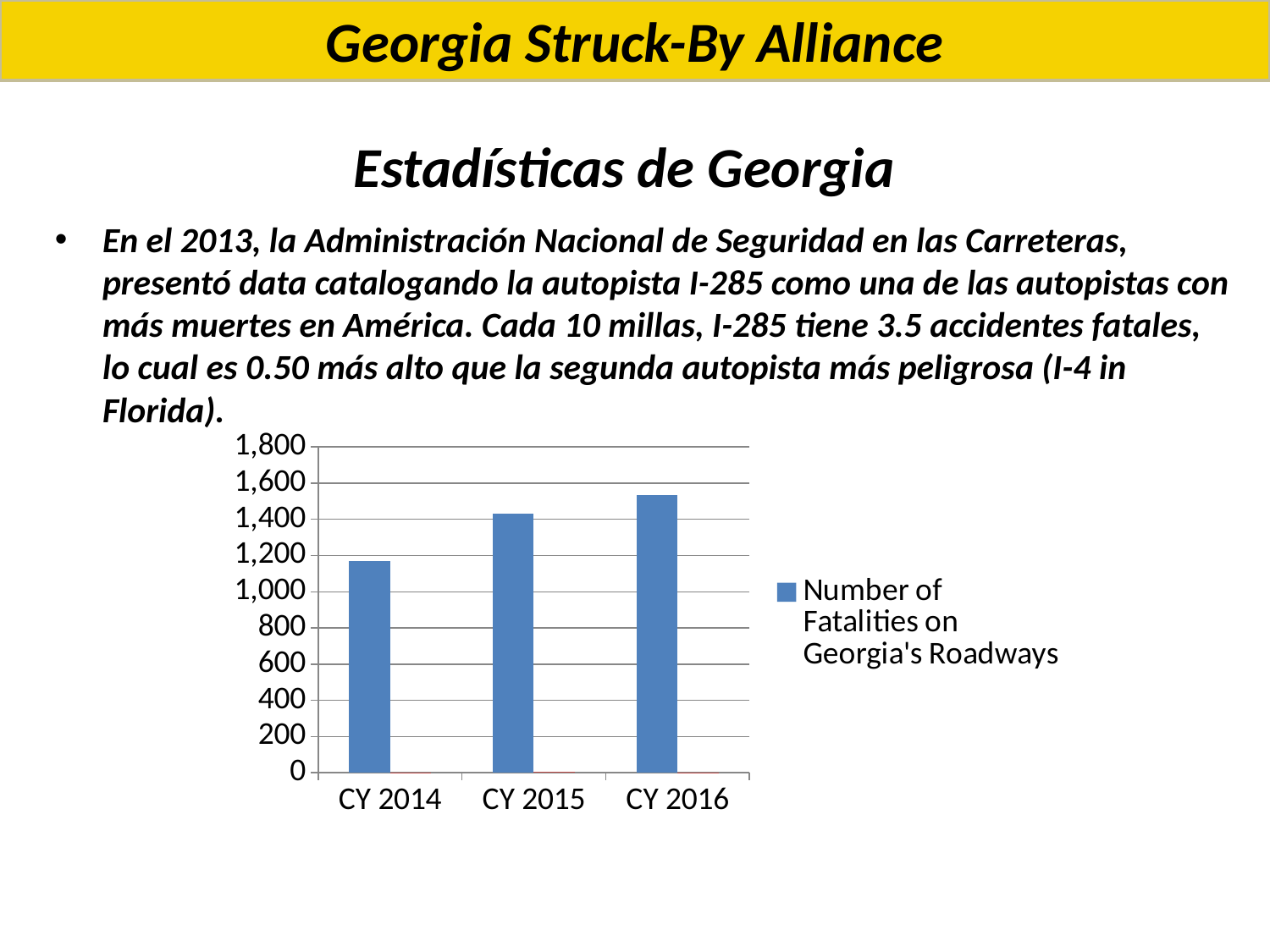
Which is larger, the value for CY 2015 or the value for CY 2016? CY 2016 Is the value for CY 2014 greater or less than 1,000? greater Is the value for CY 2014 greater or less than 1,200? less What kind of chart is shown on the slide? bar chart How many series does the chart's legend list? 1 Is the value for CY 2015 greater or less than 1,600? less Which year has the highest number of fatalities on Georgia's roadways? CY 2016 Do the values rise or fall from CY 2014 to CY 2016? rise Which year has the lowest number of fatalities on Georgia's roadways? CY 2014 What is the legend entry of the chart? Number of Fatalities on Georgia's Roadways How many categories are shown on the x axis of the chart? 3